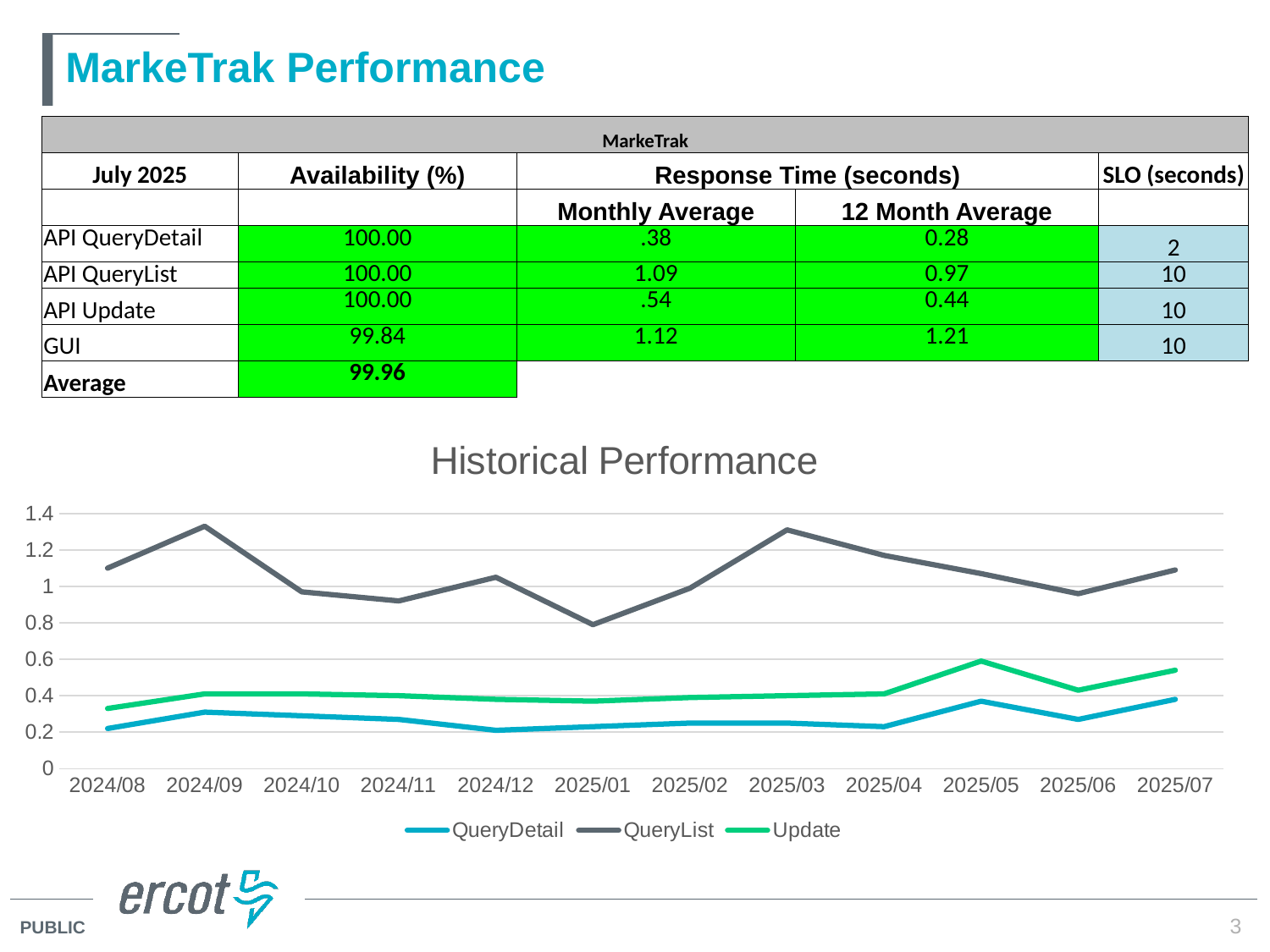
In the Historical Performance chart, in which month does the QueryList series reach its lowest value? 2025/01 In the Historical Performance chart, which series has the highest values across all months? QueryList What kind of chart is the Historical Performance chart? line chart In the Historical Performance chart, does the QueryList series rise or fall from 2025/03 to 2025/06? fall In the Historical Performance chart, is the QueryDetail value for 2024/12 greater or less than 0.4? less How many series does the legend of the Historical Performance chart list? 3 How many months are plotted along the x axis of the Historical Performance chart? 12 In the Historical Performance chart, is the QueryList value for 2024/09 greater or less than 1.2? greater What is the title of the line chart on the slide? Historical Performance In the Historical Performance chart, which is larger at 2025/03: the QueryList value or the Update value? QueryList In the Historical Performance chart, is the Update value for 2025/05 greater or less than 0.4? greater In the Historical Performance chart, in which month does the Update series reach its highest value? 2025/05